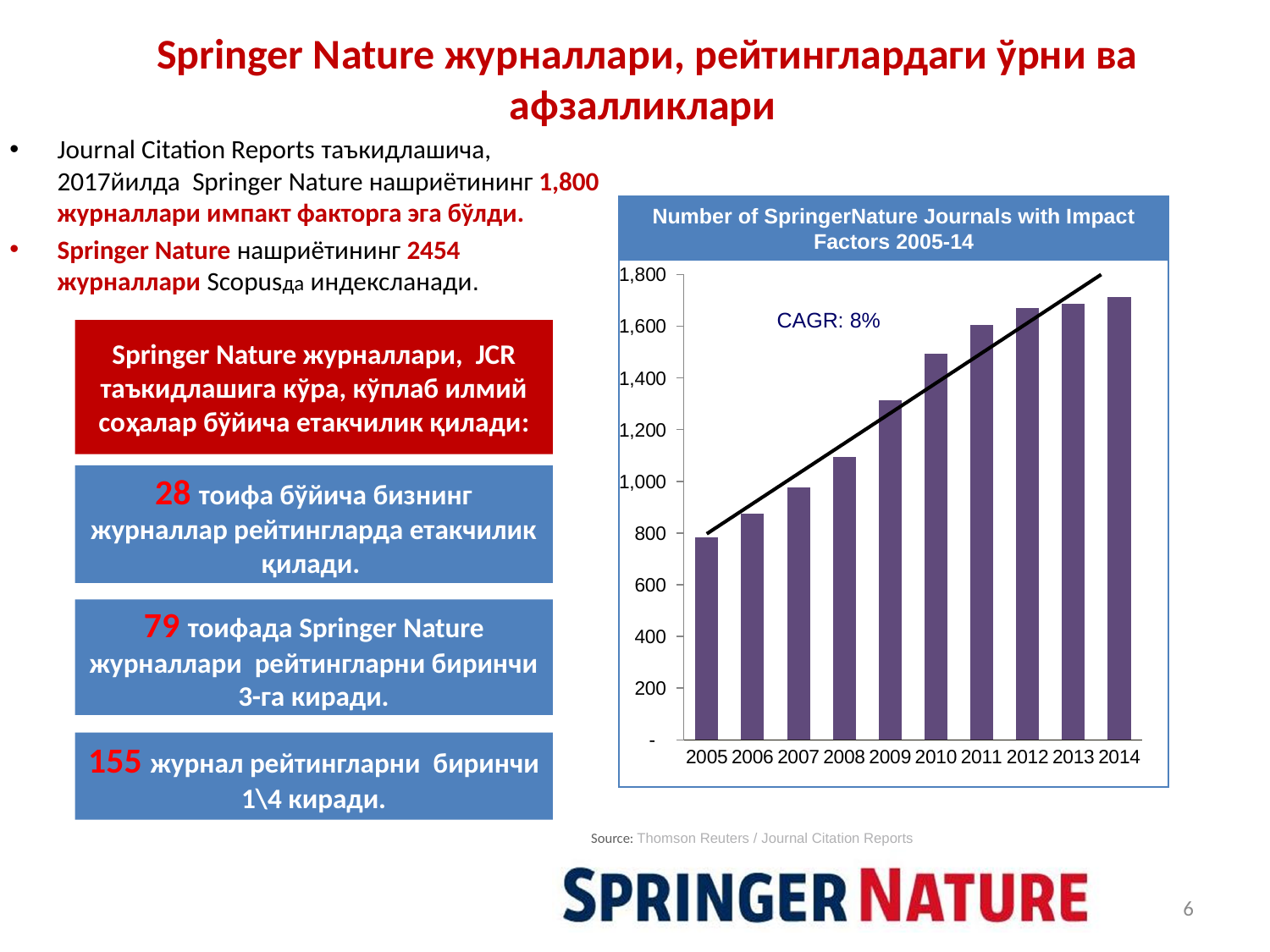
Is the value for 2009 greater or less than 1,200? greater How many years are shown on the x axis of the chart? 10 Is the value for 2005 greater or less than 1,000? less Which is larger, the value for 2012 or the value for 2008? 2012 Is the value for 2010 greater or less than 1,400? greater What kind of chart is shown on the slide? bar chart What CAGR is annotated on the chart? 8% What is the title of the chart? Number of SpringerNature Journals with Impact Factors 2005-14 Which year has the lowest number of journals with impact factors? 2005 Do the values rise or fall from 2005 to 2014? rise